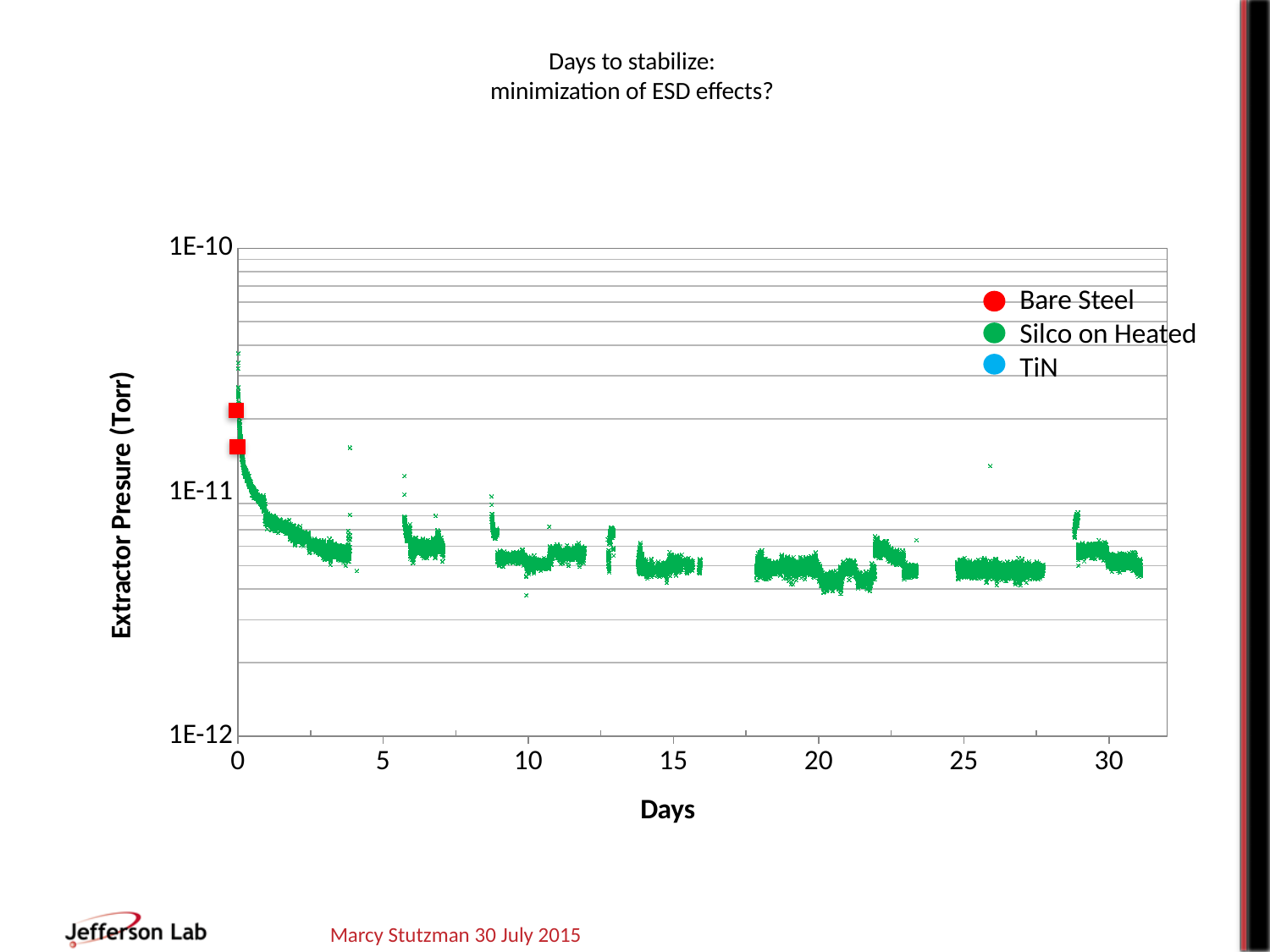
What is the highest tick value shown on the y axis? 1E-10 What kind of chart is shown on the slide? scatter chart What is the label of the x axis? Days Is the value for Bare Steel at day 0 greater or less than 1E-11? greater What is the label of the y axis? Extractor Presure (Torr) Is the value for Silco on Heated at day 30 greater or less than 1E-11? less Do the Silco on Heated values rise or fall as the number of days increases? fall Is the value for Silco on Heated at day 20 greater or less than 1E-12? greater How many series does the legend list? 3 Which is larger: the Bare Steel value at day 0 or the Silco on Heated value at day 25? Bare Steel at day 0 Which series has the highest plotted value on the chart? Silco on Heated